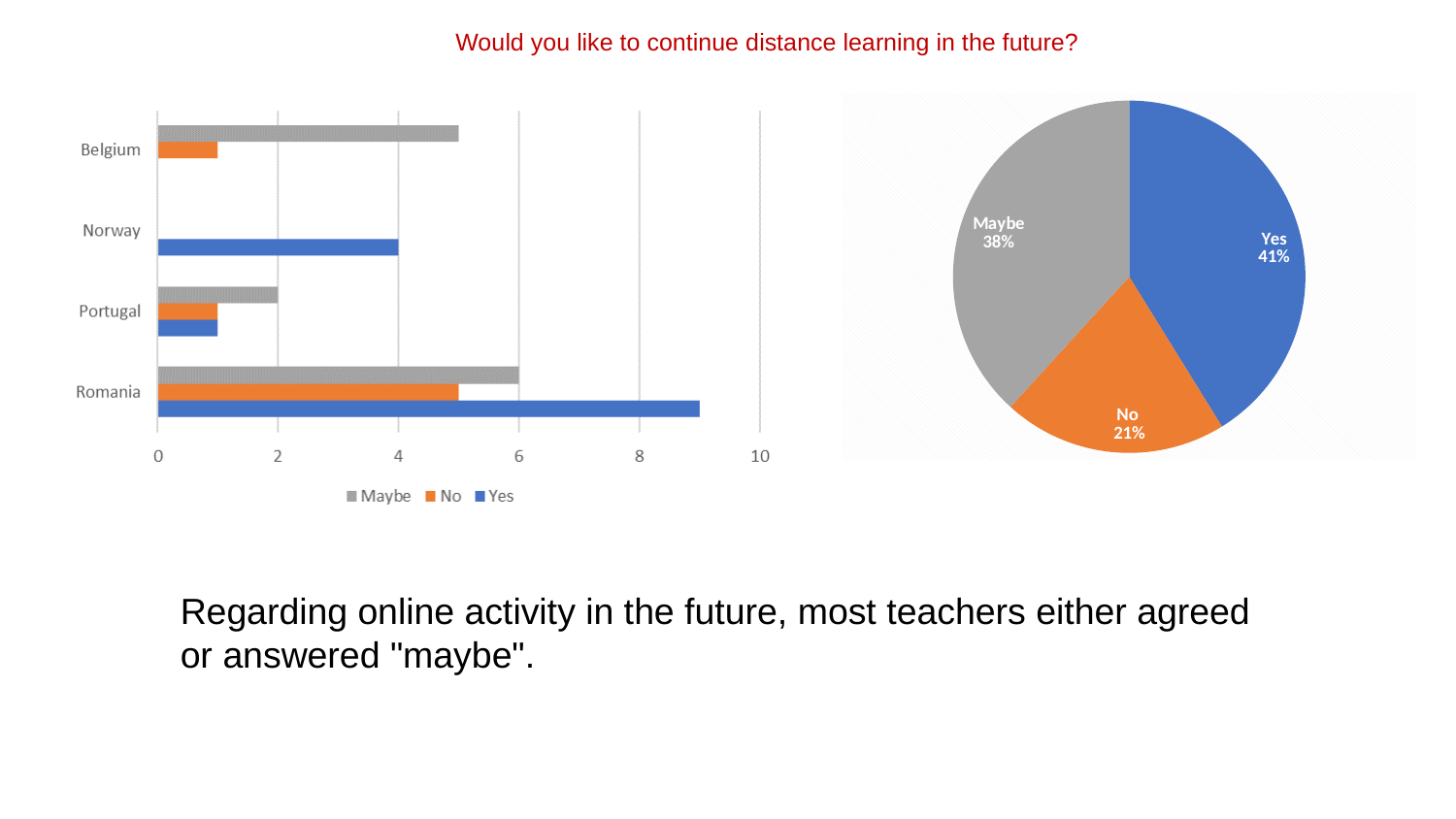
How many countries are shown in the bar chart on the left? 4 In the bar chart on the left, what is the value of the Maybe bar for Romania? 6 In the bar chart on the left, which is larger for Romania, the Maybe bar or the No bar? Maybe In the pie chart on the right, which response has the smallest slice? No In the pie chart on the right, what share of responses is Yes? 41% In the pie chart on the right, what is the difference between the Yes share and the Maybe share? 3% How many series does the legend of the bar chart on the left list? 3 In the bar chart on the left, is the Yes value for Romania greater or less than 8? greater In the bar chart on the left, is the No value for Belgium greater or less than 2? less In the bar chart on the left, what is the value of the Yes bar for Norway? 4 In the bar chart on the left, what is the value of the Maybe bar for Portugal? 2 In the bar chart on the left, which country has the longest Yes bar? Romania